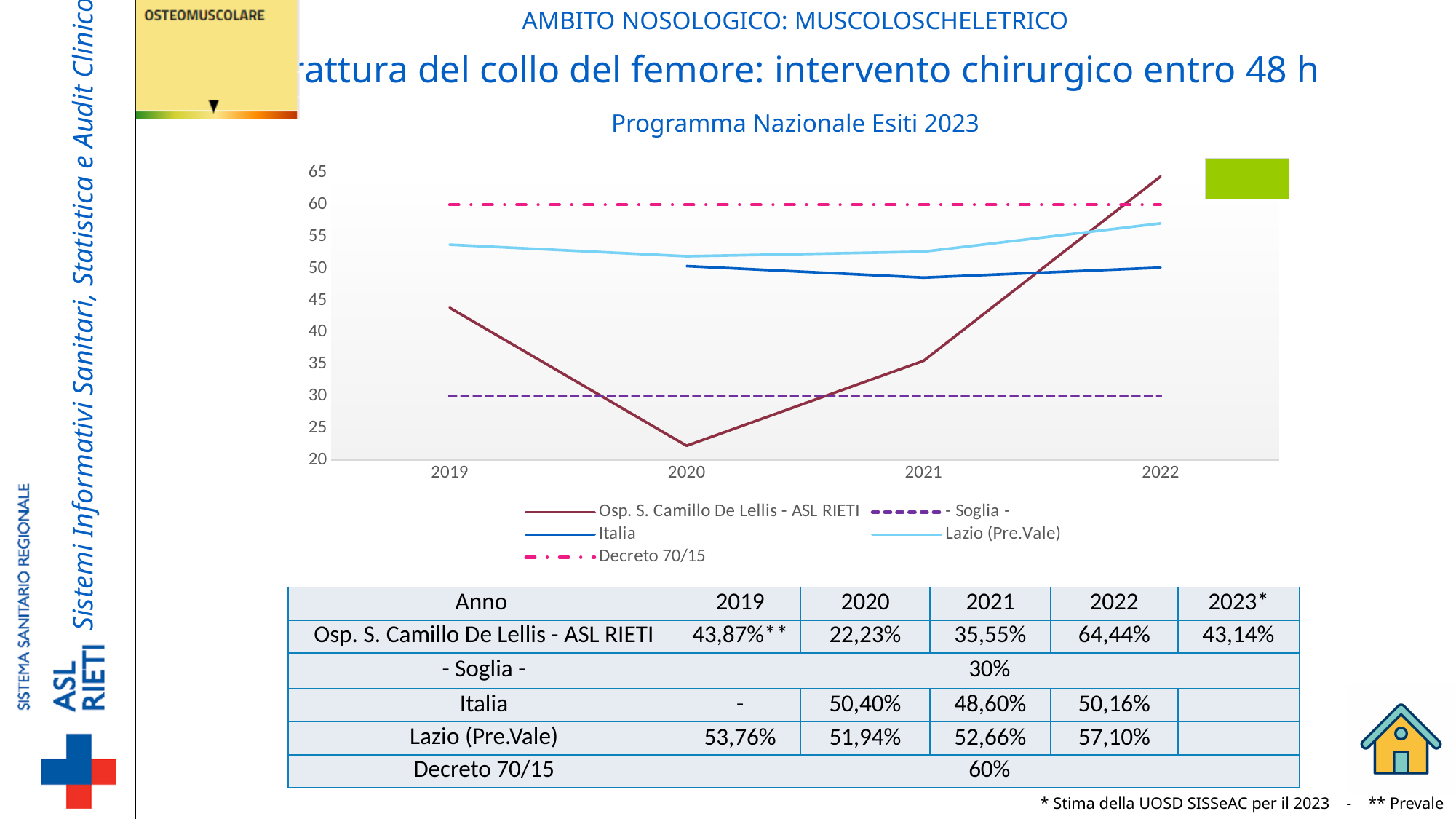
How many years are plotted along the x axis of the chart? 4 In which year is the value for Osp. S. Camillo De Lellis - ASL RIETI highest? 2022 What is the value for Lazio (Pre.Vale) in 2022? 57,10% In 2021, which is larger: the value for Italia or for Lazio (Pre.Vale)? Lazio (Pre.Vale) What kind of chart is shown on the slide? line chart Is the 2020 value for Osp. S. Camillo De Lellis - ASL RIETI greater or less than 30? less What is the value for Osp. S. Camillo De Lellis - ASL RIETI in 2020? 22,23% What is the difference between the 2022 and 2021 values for Osp. S. Camillo De Lellis - ASL RIETI? 28,89% What value does the Decreto 70/15 line represent? 60% In which year is the value for Osp. S. Camillo De Lellis - ASL RIETI lowest? 2020 How many series does the chart legend list? 5 What is the value for Italia in 2021? 48,60%